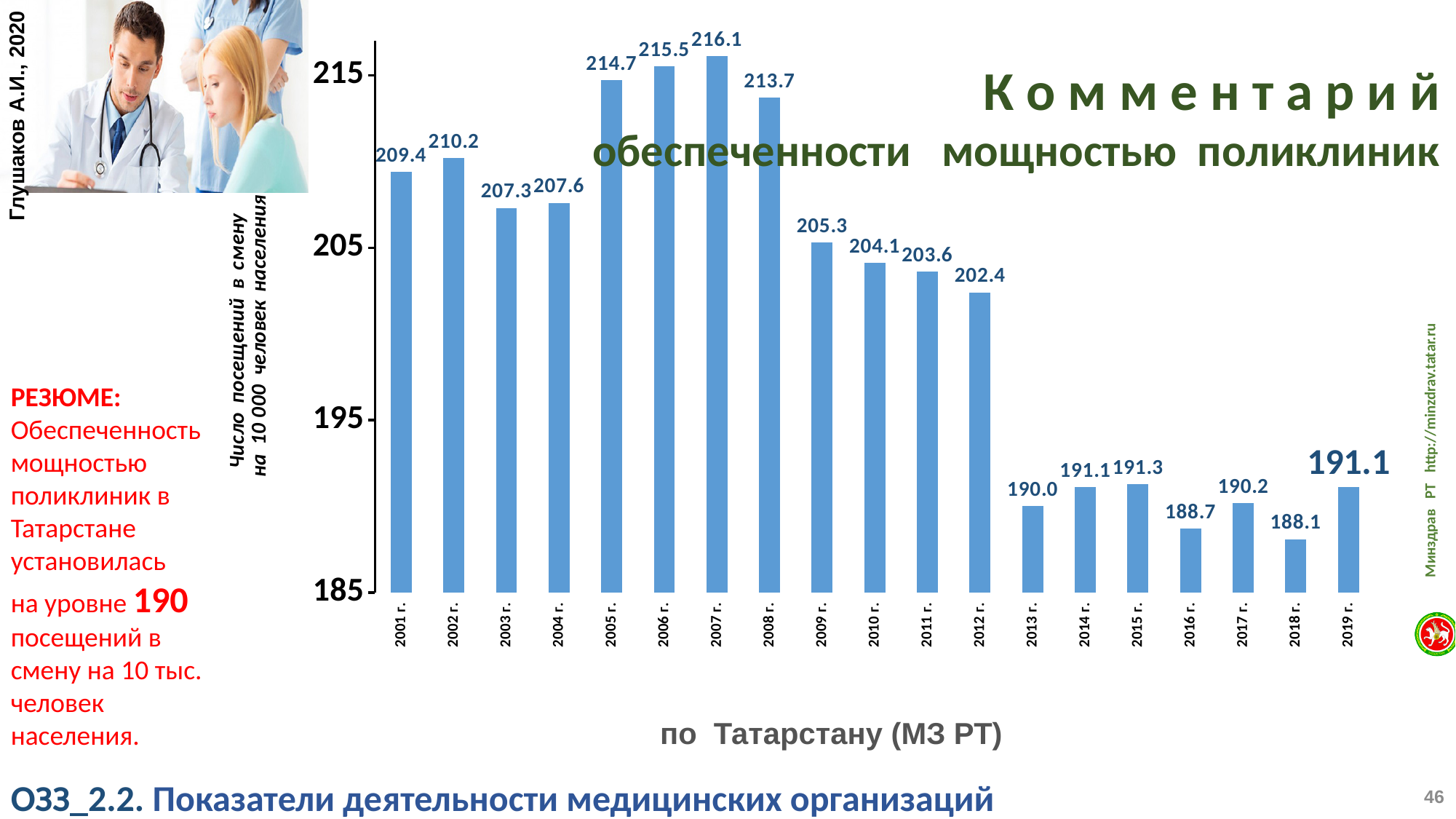
What kind of chart is this? bar chart Do the values generally rise or fall from 2001 г. to 2019 г.? fall What is the label of the vertical axis? Число посещений в смену на 10 000 человек населения Which year has the lowest value? 2018 г. What is the value for 2007 г.? 216.1 What is the value for 2019 г.? 191.1 Which is larger, the value for 2001 г. or 2002 г.? 2002 г. What is the value for 2012 г.? 202.4 What is the difference between the values for 2007 г. and 2018 г.? 28.0 Which year has the highest value? 2007 г. Is the value for 2012 г. greater or less than 195? greater How many years are shown on the x axis? 19